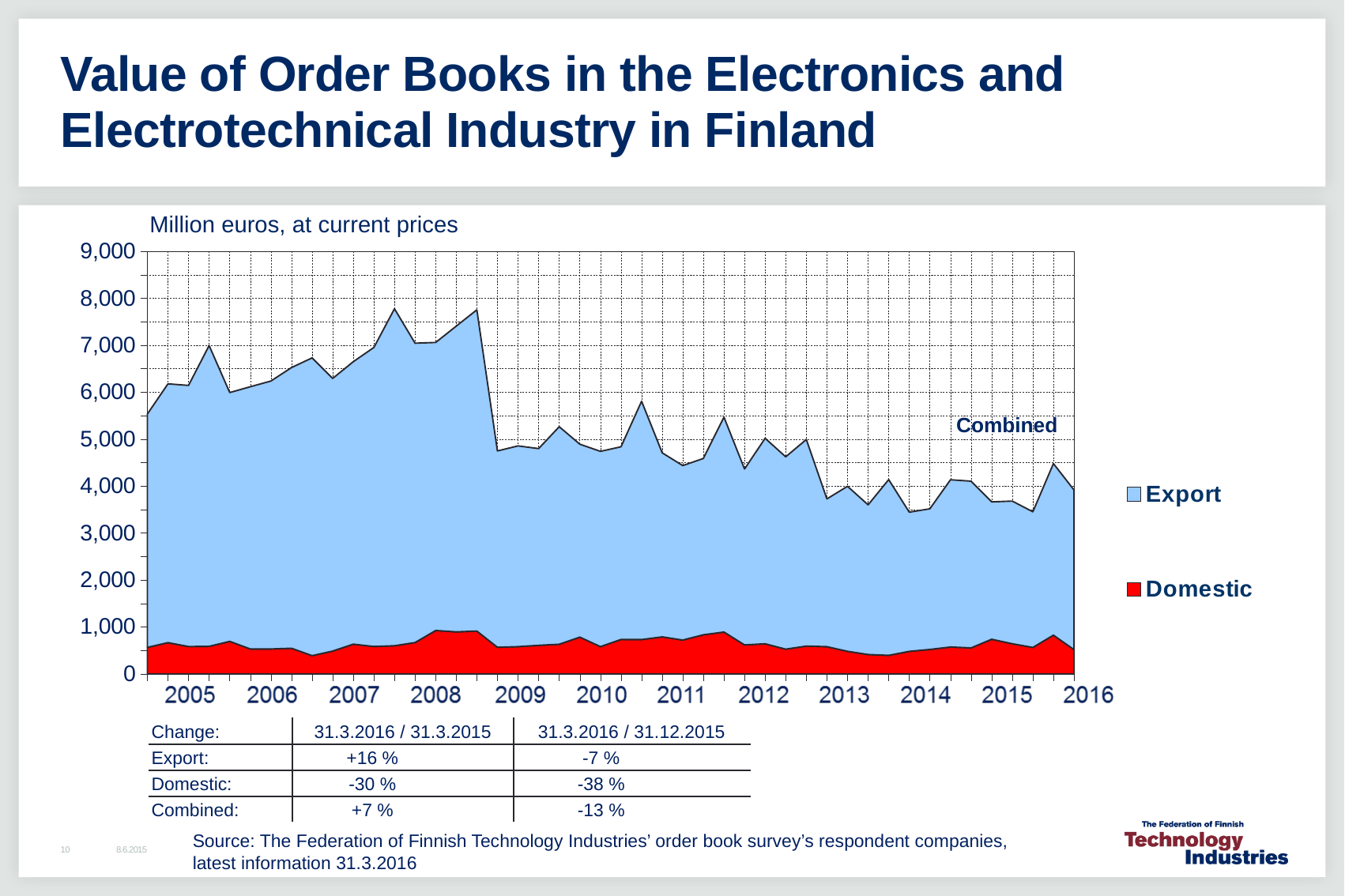
Is the Domestic value in 2008 greater or less than 1,000? less Is the combined value at the end of the series in 2016 greater or less than 5,000? less What unit is stated for the values on the chart? Million euros, at current prices Which is larger, the combined value in 2008 or the combined value in 2013? 2008 Does the combined value rise or fall between mid-2008 and 2009? fall Which series is shown in red on the chart? Domestic Is the combined value in 2013 greater or less than 5,000? less What kind of chart is shown on the slide? area chart How many series does the chart legend list? 2 Which is larger in 2010, the Export value or the Domestic value? Export